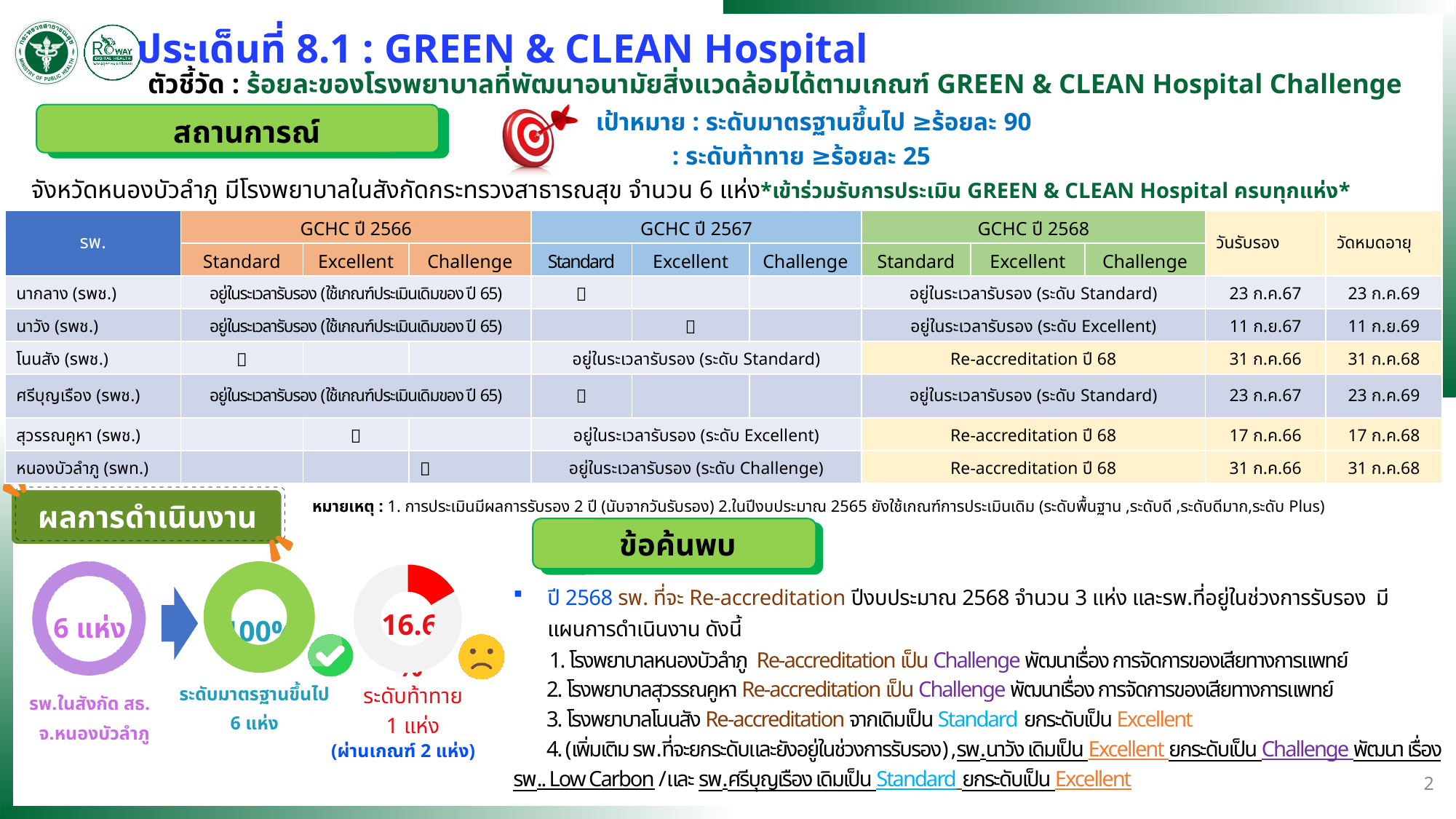
According to the caption under the third donut chart, how many hospitals are at ระดับท้าทาย? 1 แห่ง How many donut charts are shown at the bottom left of the slide? 2 In the third donut chart (ระดับท้าทาย), which is larger: the red slice or the grey remainder? The grey remainder In the third donut chart (ระดับท้าทาย), what share of the ring is the red slice? 16.6% What colour is the ring of the first donut chart labelled รพ.ในสังกัด สธ. จ.หนองบัวลำภู? Purple According to the caption under the second (green) donut chart, how many hospitals are at ระดับมาตรฐานขึ้นไป? 6 แห่ง What kind of charts are shown at the bottom left of the slide? Donut (pie) charts What value is printed in the centre of the third donut chart (ระดับท้าทาย)? 16.6% What value is printed in the centre of the first (purple) donut chart? 6 แห่ง What colour is the second donut chart labelled ระดับมาตรฐานขึ้นไป? Green